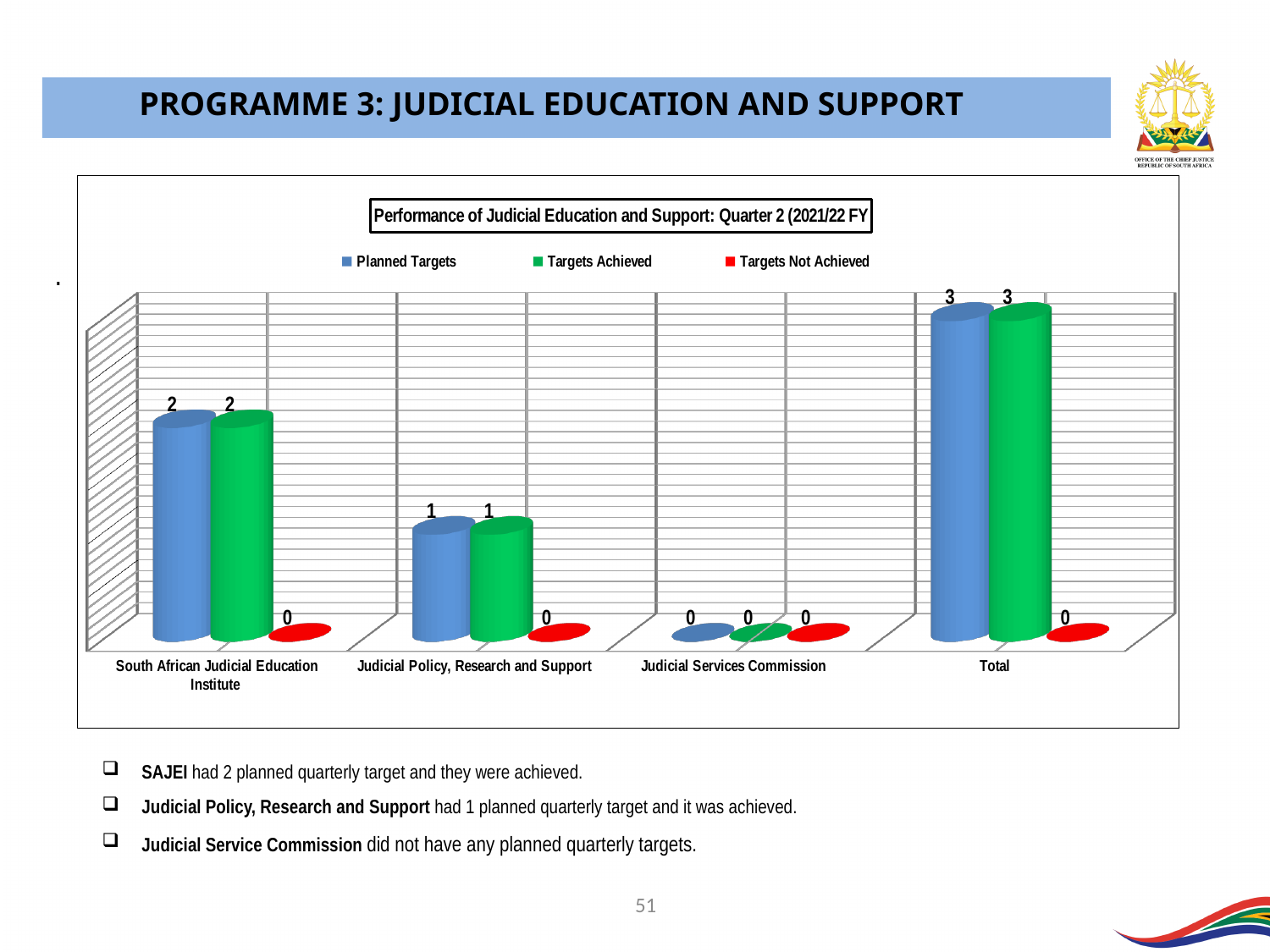
Which is larger: the Planned Targets for South African Judicial Education Institute or for Judicial Policy, Research and Support? South African Judicial Education Institute What is the Targets Achieved value for Judicial Policy, Research and Support? 1 Which category has the highest Planned Targets value? Total What is the difference between the Planned Targets for Total and for South African Judicial Education Institute? 1 What is the title of the chart? Performance of Judicial Education and Support: Quarter 2 (2021/22 FY) How many series does the legend list? 3 How many categories are shown on the x axis? 4 What is the Planned Targets value for South African Judicial Education Institute? 2 What kind of chart is shown? Bar chart What is the Planned Targets value for Judicial Services Commission? 0 Which category has the lowest Targets Achieved value? Judicial Services Commission What is the Targets Not Achieved value for Total? 0